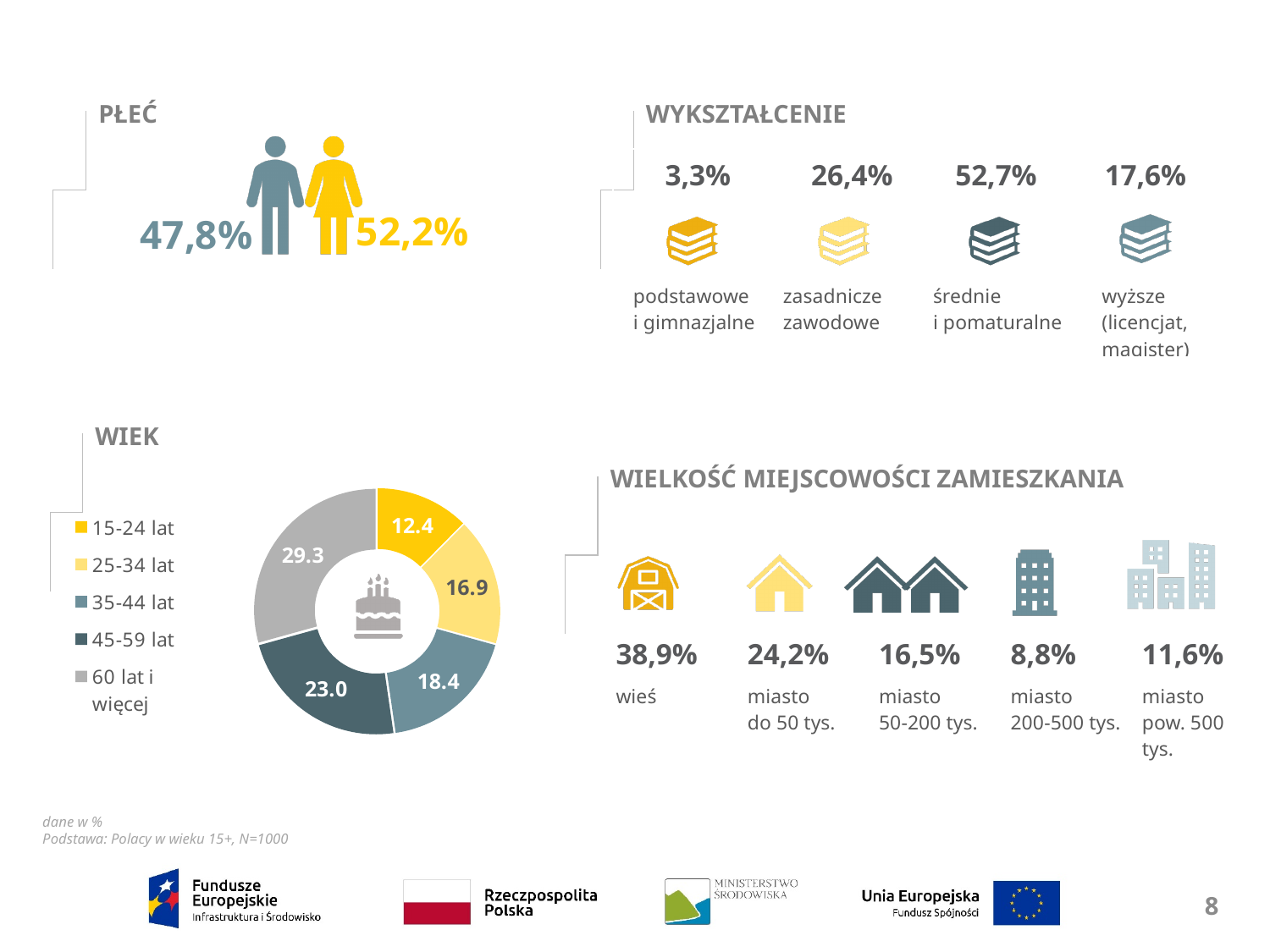
In the WIEK chart, what is the value for 15-24 lat? 12.4 In the WIEK chart, which age group has the largest value? 60 lat i więcej In the WIEK chart, what is the difference between the values for 60 lat i więcej and 15-24 lat? 16.9 In the WIEK chart, what is the difference between the values for 45-59 lat and 35-44 lat? 4.6 In the WIEK chart, what is the value for 45-59 lat? 23.0 In the WIEK chart, what colour is the slice for 15-24 lat? Yellow In the WIEK chart, what is the value for 25-34 lat? 16.9 In the WIEK chart, which age group has the smallest value? 15-24 lat In the WIEK chart, which is larger: the value for 25-34 lat or the value for 35-44 lat? 35-44 lat In the WIEK chart, what is the value for 35-44 lat? 18.4 What kind of chart is the WIEK chart? Donut (pie) chart How many age groups are shown in the WIEK chart? 5